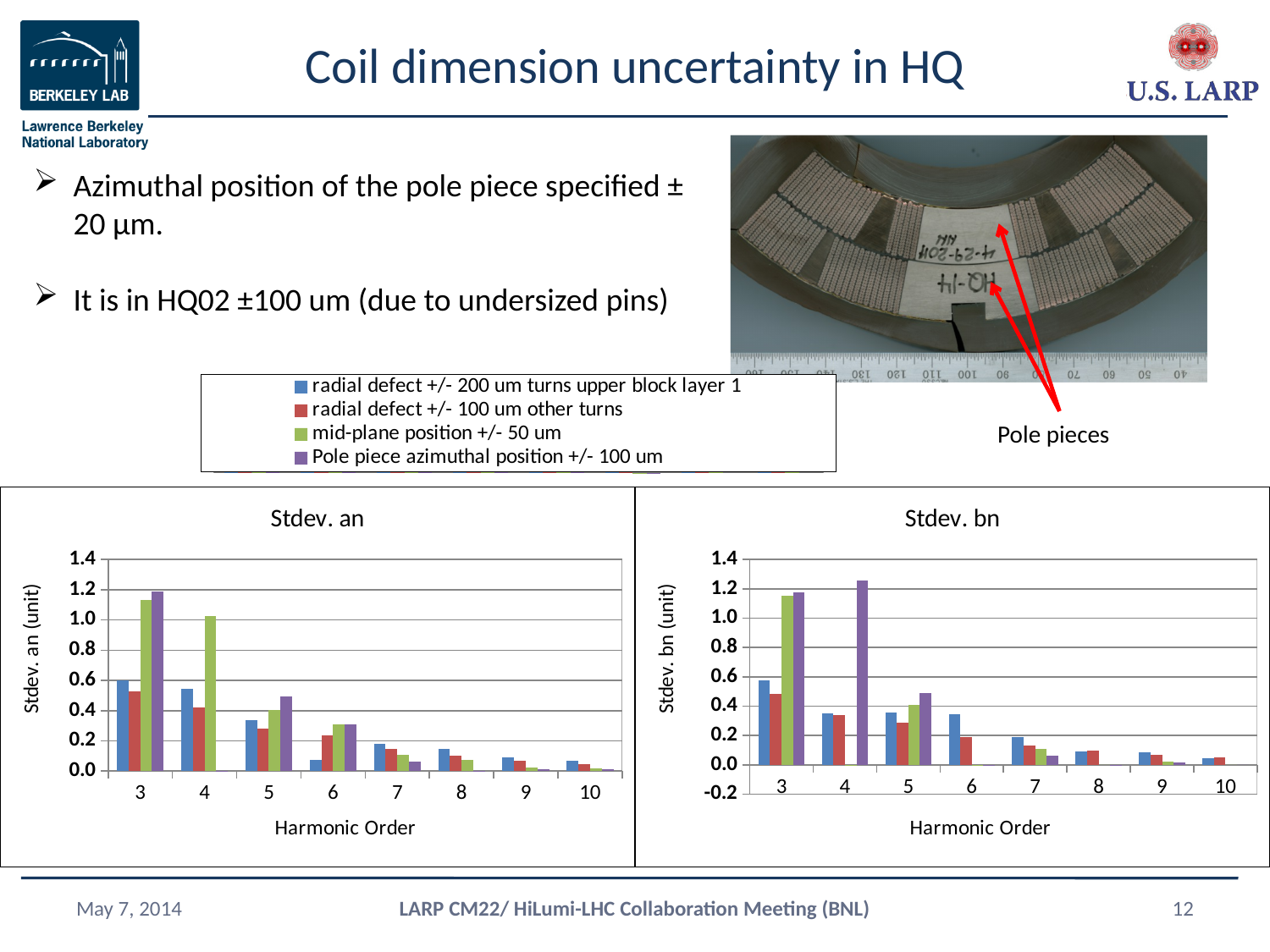
In the "Stdev. bn" chart, is the value for "Pole piece azimuthal position +/- 100 um" at harmonic order 4 greater or less than 1.0? greater What kind of chart is the "Stdev. an" chart? bar chart In the "Stdev. bn" chart, is the value for "radial defect +/- 100 um other turns" at harmonic order 6 greater or less than 0.4? less What is the y-axis title of the "Stdev. bn" chart? Stdev. bn (unit) In the "Stdev. bn" chart, at which harmonic order is the bar for "Pole piece azimuthal position +/- 100 um" tallest? 4 How many harmonic orders are shown on the x axis of the "Stdev. bn" chart? 8 In the "Stdev. an" chart, is the value for "radial defect +/- 200 um turns upper block layer 1" at harmonic order 3 greater or less than 0.4? greater In the "Stdev. bn" chart, does the "radial defect +/- 200 um turns upper block layer 1" series generally rise or fall from harmonic order 3 to 10? fall What is the lowest tick value shown on the y axis of the "Stdev. bn" chart? -0.2 How many series does the legend above the charts list? 4 In the "Stdev. an" chart at harmonic order 6, which is larger: "radial defect +/- 100 um other turns" or "radial defect +/- 200 um turns upper block layer 1"? radial defect +/- 100 um other turns